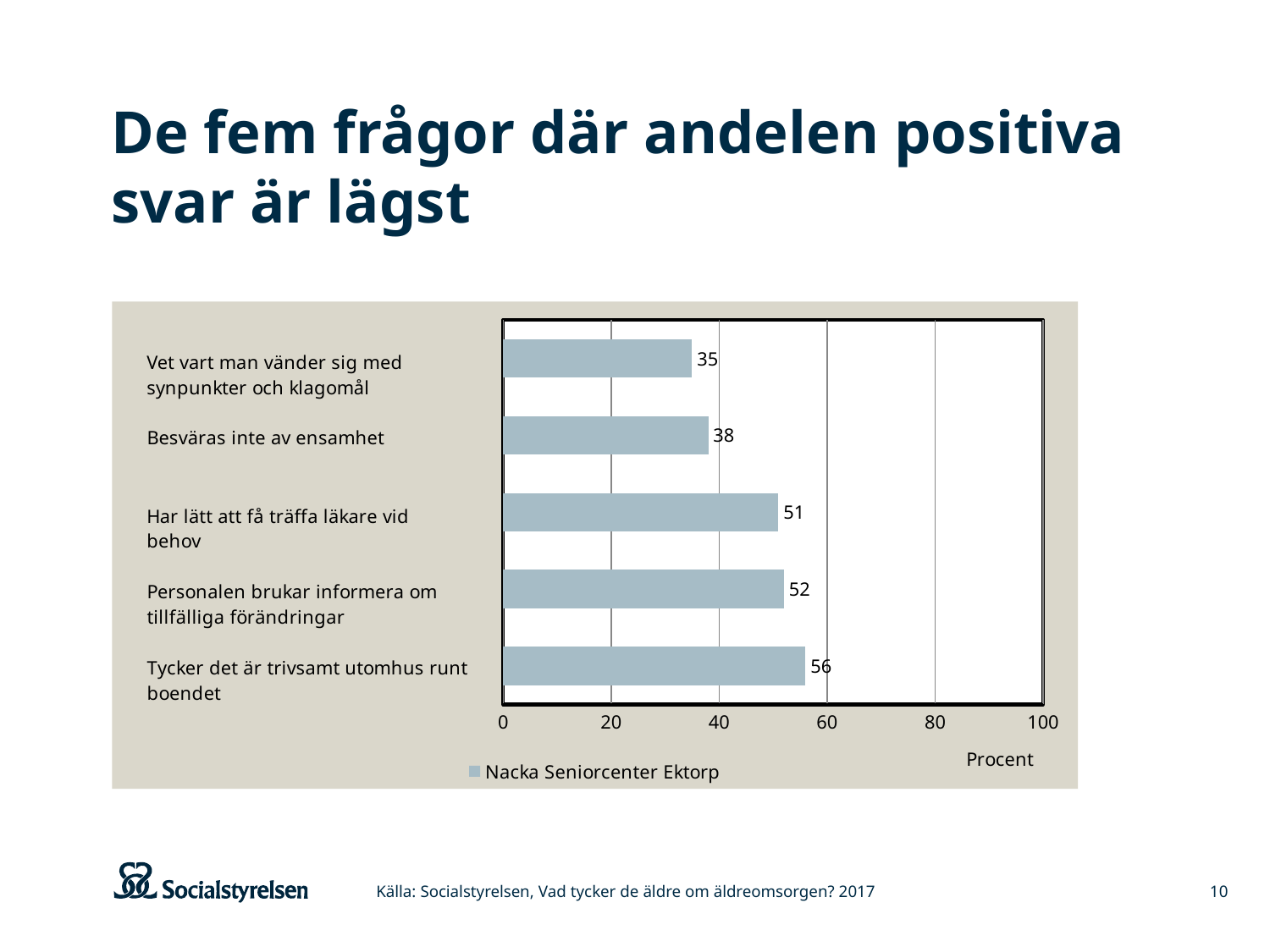
How many categories are shown in the chart? 5 What is the value for "Har lätt att få träffa läkare vid behov"? 51 Which category has the lowest value? Vet vart man vänder sig med synpunkter och klagomål What is the difference between the values for "Tycker det är trivsamt utomhus runt boendet" and "Vet vart man vänder sig med synpunkter och klagomål"? 21 Which category has the highest value? Tycker det är trivsamt utomhus runt boendet What is the value for "Tycker det är trivsamt utomhus runt boendet"? 56 How many series does the legend list? 1 Which is larger: the value for "Besväras inte av ensamhet" or the value for "Personalen brukar informera om tillfälliga förändringar"? Personalen brukar informera om tillfälliga förändringar What is the value for "Besväras inte av ensamhet"? 38 What kind of chart is shown on the slide? bar chart What is the name of the series shown in the legend? Nacka Seniorcenter Ektorp Is the value for "Vet vart man vänder sig med synpunkter och klagomål" greater or less than 40? less